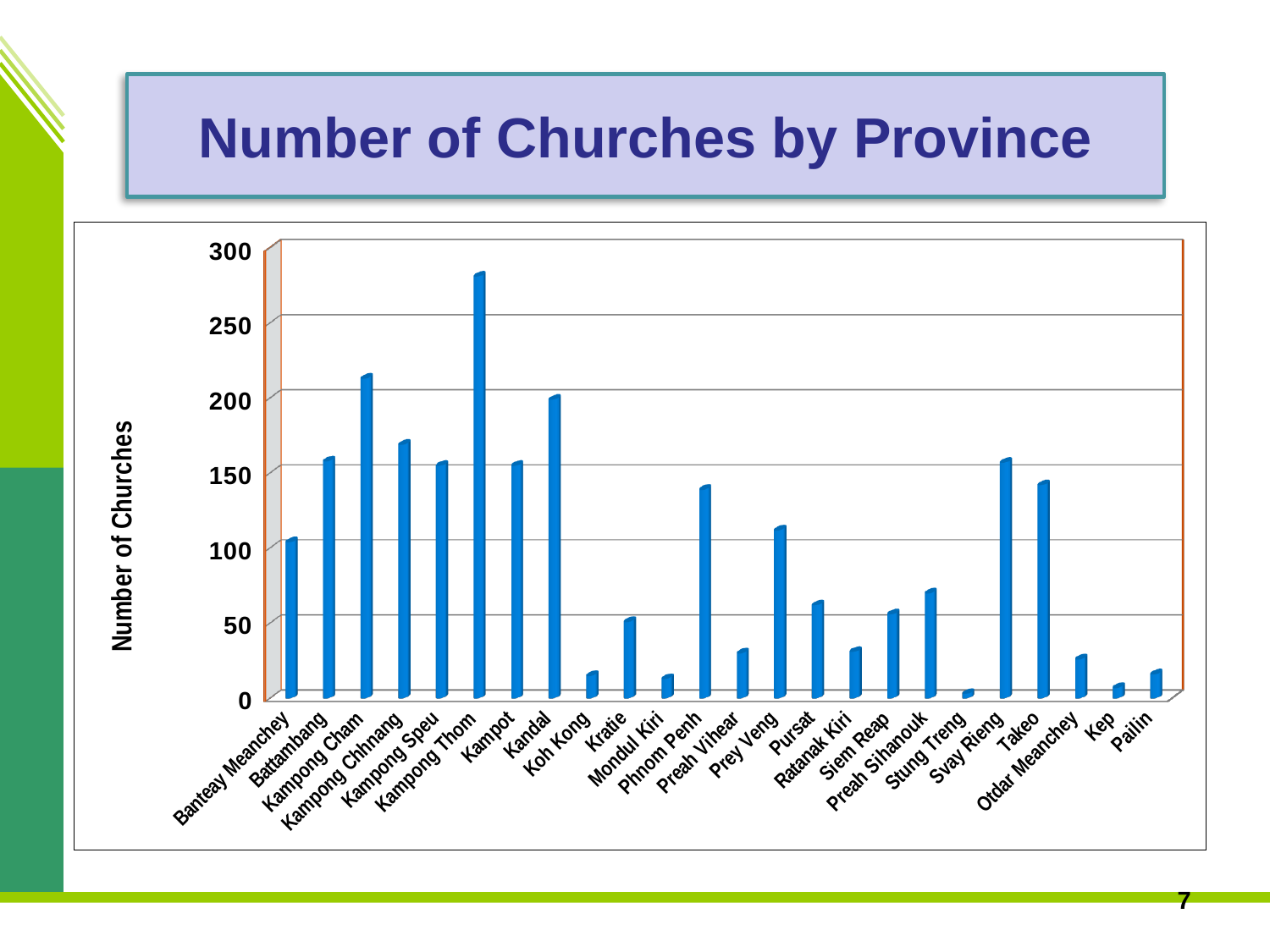
What is the label of the vertical axis? Number of Churches How many provinces are shown on the x axis? 24 What is the title of the chart? Number of Churches by Province Which has more churches, Kampong Thom or Kampong Cham? Kampong Thom What type of chart is shown on the slide? bar chart Is the value for Prey Veng greater or less than 100? greater Which province has the lowest number of churches? Stung Treng Which has more churches, Preah Sihanouk or Ratanak Kiri? Preah Sihanouk Is the value for Kampong Cham greater or less than 200? greater Which province has the highest number of churches? Kampong Thom Is the value for Koh Kong greater or less than 50? less